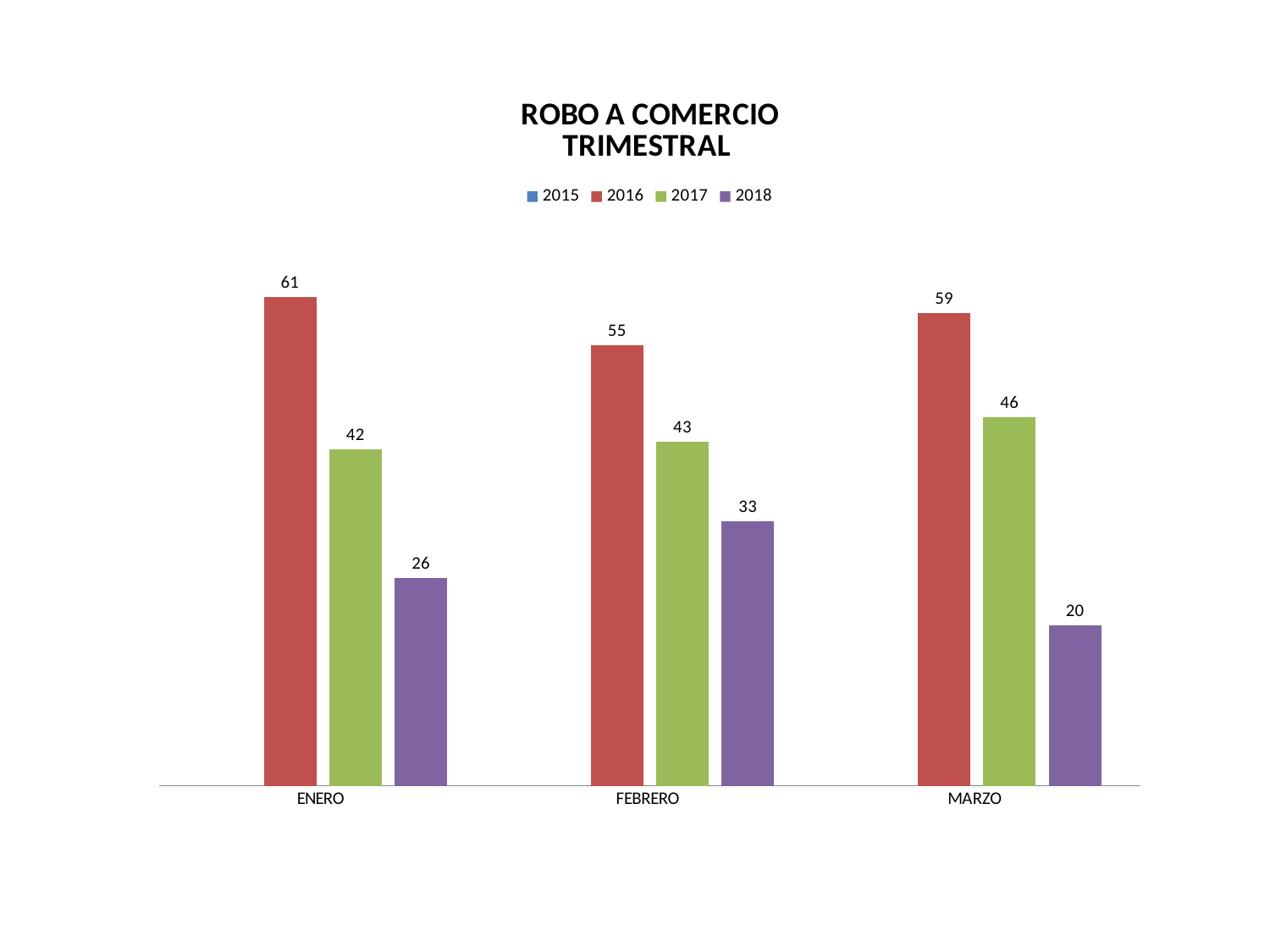
Which month has the lowest value for 2016? FEBRERO What kind of chart is shown? Bar chart What is the value for 2017 in FEBRERO? 43 What is the value for 2018 in MARZO? 20 What is the difference between the 2016 and 2018 values in ENERO? 35 How many months are shown on the x axis? 3 Do the 2018 values rise or fall from FEBRERO to MARZO? Fall Which is larger, the 2017 value in MARZO or the 2017 value in ENERO? MARZO What is the value for 2016 in ENERO? 61 How many series does the legend list? 4 What is the title of the chart? ROBO A COMERCIO TRIMESTRAL Which month has the highest value for 2018? FEBRERO